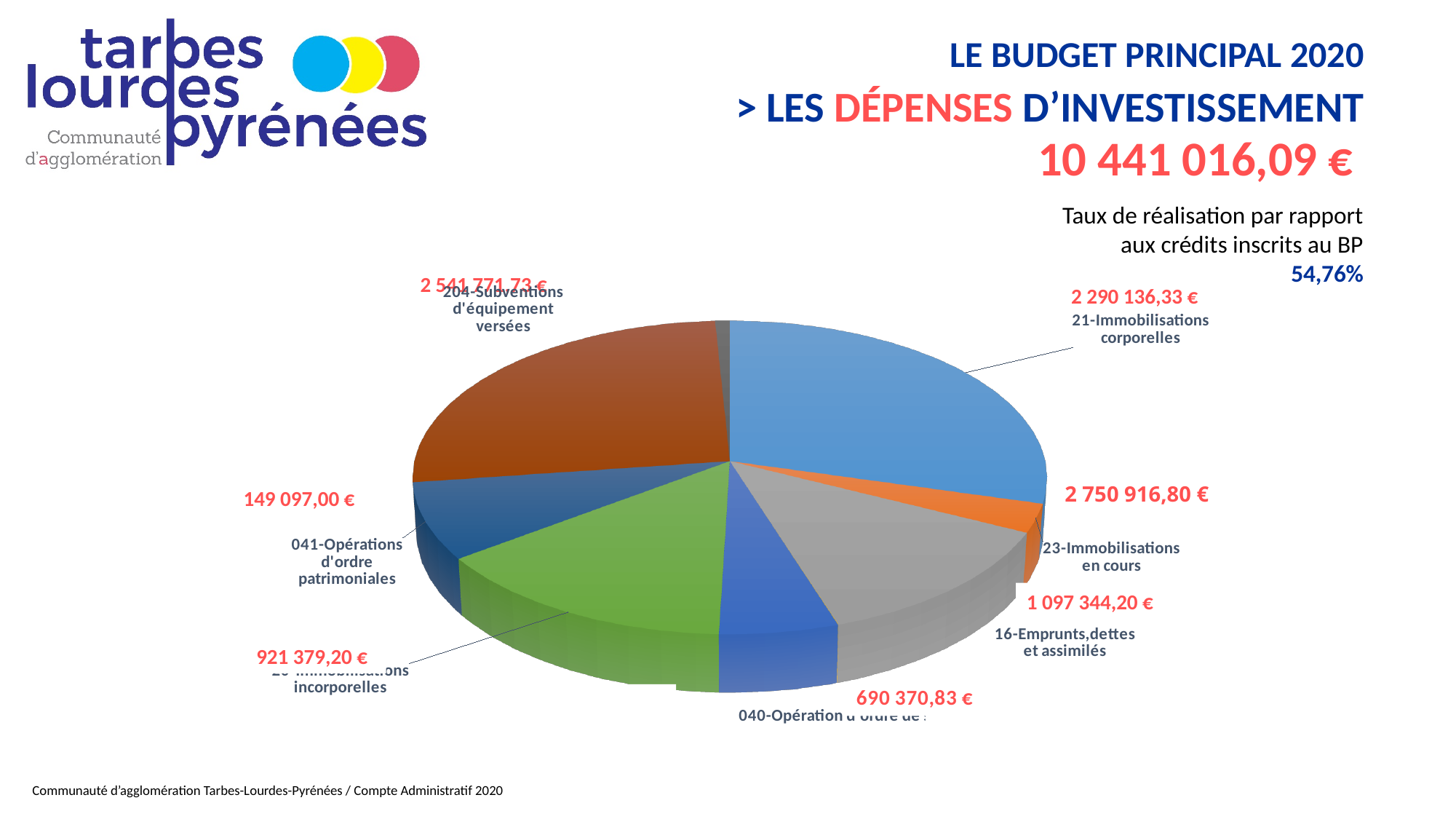
What is the value shown for 23-Immobilisations en cours? 2 750 916,80 € What total amount for the dépenses d'investissement is printed on the slide? 10 441 016,09 € Which category has the highest value according to the printed labels? 23-Immobilisations en cours How many categories are labelled on the pie chart? 7 What type of chart is shown on the slide? pie chart What is the value shown for 20-Immobilisations incorporelles? 921 379,20 € What is the value shown for 16-Emprunts, dettes et assimilés? 1 097 344,20 € What is the value shown for 21-Immobilisations corporelles? 2 290 136,33 € What is the value shown for 041-Opérations d'ordre patrimoniales? 149 097,00 € What is the difference between the values for 23-Immobilisations en cours and 21-Immobilisations corporelles? 460 780,47 € Which category has the lowest value according to the printed labels? 041-Opérations d'ordre patrimoniales Which is larger: the value for 16-Emprunts, dettes et assimilés or the value for 20-Immobilisations incorporelles? 16-Emprunts, dettes et assimilés